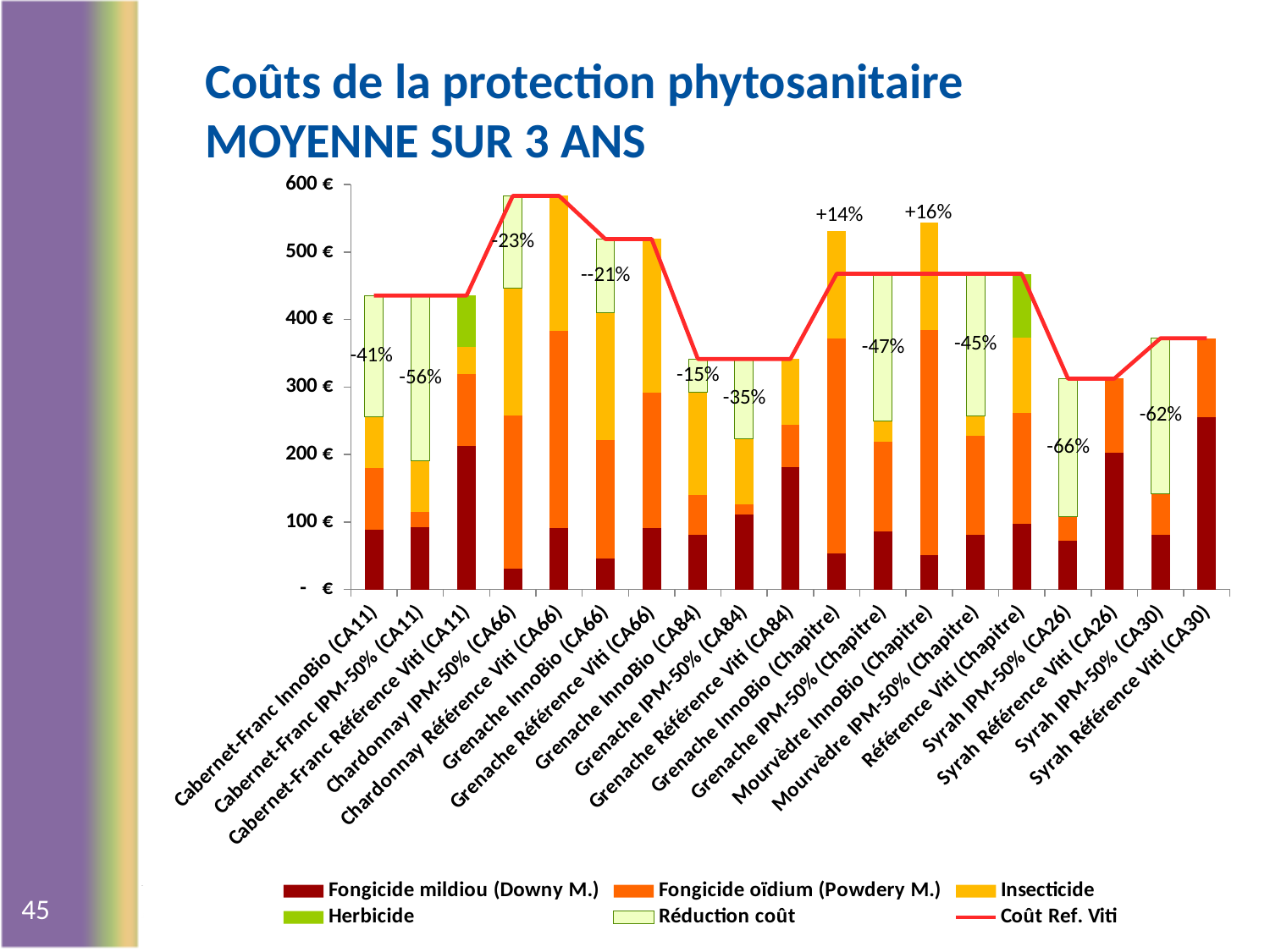
Which bar is taller: Chardonnay Référence Viti (CA66) or Grenache Référence Viti (CA84)? Chardonnay Référence Viti (CA66) How many entries does the chart legend list? 6 What kind of chart is shown on the slide? Stacked bar chart with a line What percentage label is shown for Chardonnay IPM-50% (CA66)? -23% What percentage label is shown for Syrah IPM-50% (CA26)? -66% How many categories are shown on the x axis of the chart? 19 Is the total bar height for Chardonnay Référence Viti (CA66) greater or less than 500 €? greater What percentage label is shown above the bar for Cabernet-Franc IPM-50% (CA11)? -56% What percentage label is shown for Mourvèdre InnoBio (Chapitre)? +16% What is the name of the red line series in the legend? Coût Ref. Viti What percentage label is shown for Grenache InnoBio (Chapitre)? +14% Is the total bar height for Syrah Référence Viti (CA26) greater or less than 400 €? less